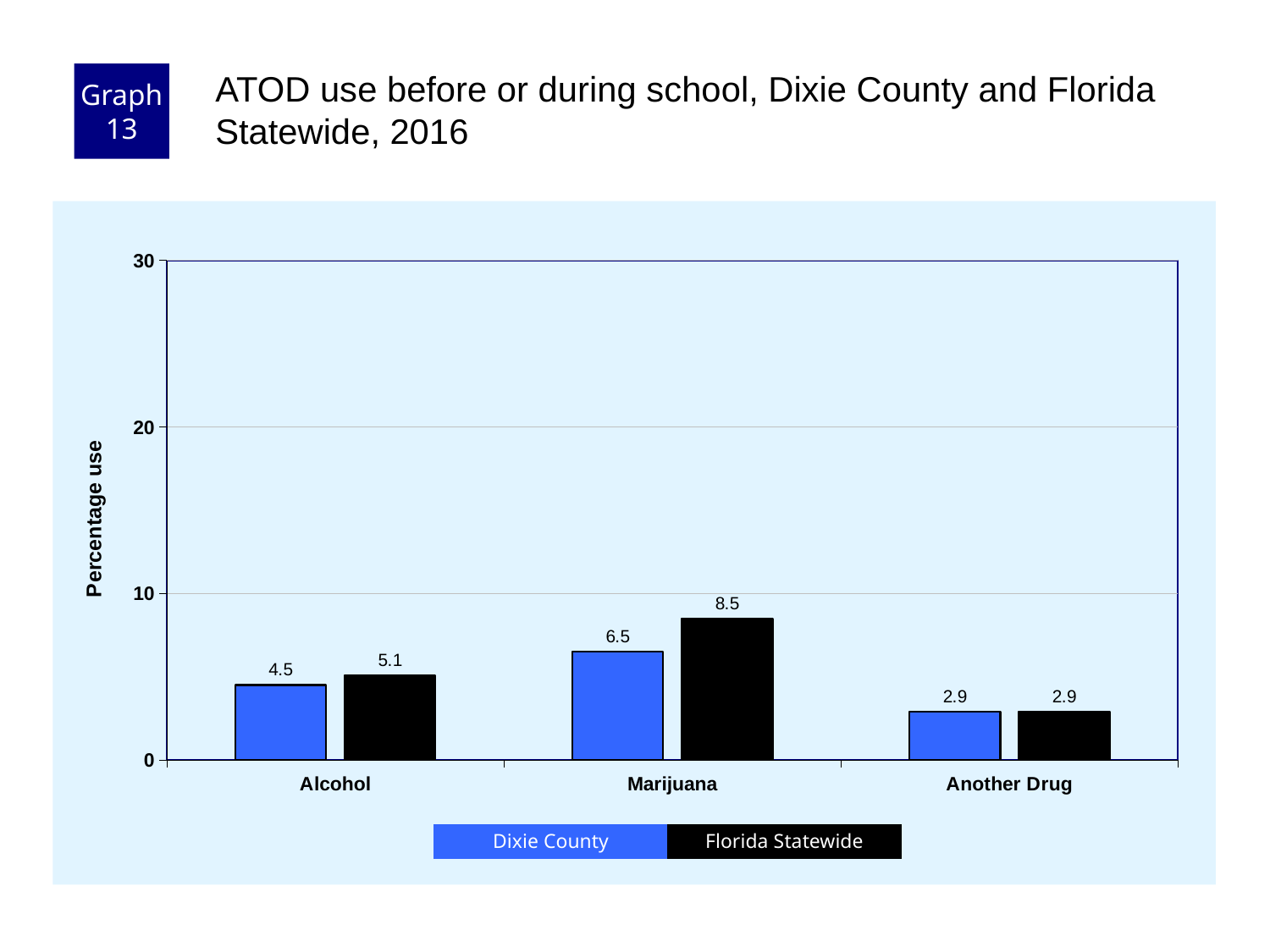
What is the Dixie County value for Another Drug? 2.9 Is the Florida Statewide value for Marijuana greater or less than 10? less Which category has the lowest Dixie County value? Another Drug How many series does the legend list? 2 What is the difference between the Florida Statewide and Dixie County values for Marijuana? 2.0 What kind of chart is shown on the slide? bar chart What is the Dixie County value for Alcohol? 4.5 Which category has the highest Florida Statewide value? Marijuana Which is larger for Alcohol, the Dixie County value or the Florida Statewide value? Florida Statewide How many categories are shown on the x axis? 3 What is the Florida Statewide value for Marijuana? 8.5 What is the label of the y axis? Percentage use